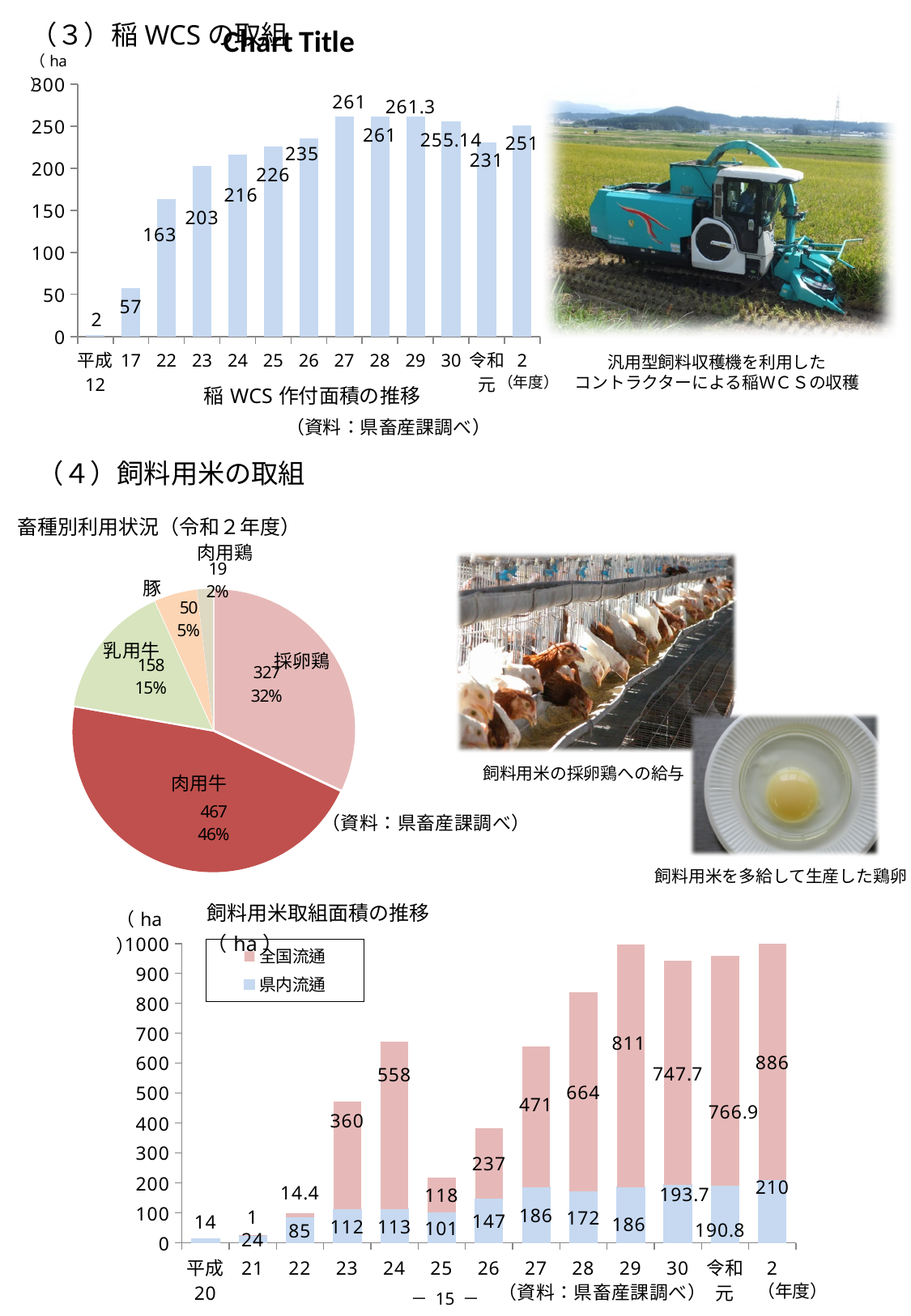
In the 稲WCS作付面積の推移 bar chart, what is the value for 平成30? 255.14 In the 稲WCS作付面積の推移 bar chart, which year has the lowest value? 平成12 In the 畜種別利用状況（令和2年度） pie chart, which category has the smallest slice? 肉用鶏 In the 稲WCS作付面積の推移 bar chart, what is the value for 平成27? 261 In the 飼料用米取組面積の推移 chart, what is the total of the stacked bar for 平成28? 836 In the 稲WCS作付面積の推移 bar chart, how many bars are plotted? 13 In the 稲WCS作付面積の推移 bar chart, what is the difference between the values for 平成22 and 平成17? 106 What kind of chart is the 飼料用米取組面積の推移 chart? stacked bar chart In the 畜種別利用状況（令和2年度） pie chart, what share does 肉用牛 have? 46% In the 畜種別利用状況（令和2年度） pie chart, what is the value for 乳用牛? 158 In the 飼料用米取組面積の推移 chart, how many series does the legend list? 2 In the 飼料用米取組面積の推移 chart, what is the 全国流通 value for 令和2? 886